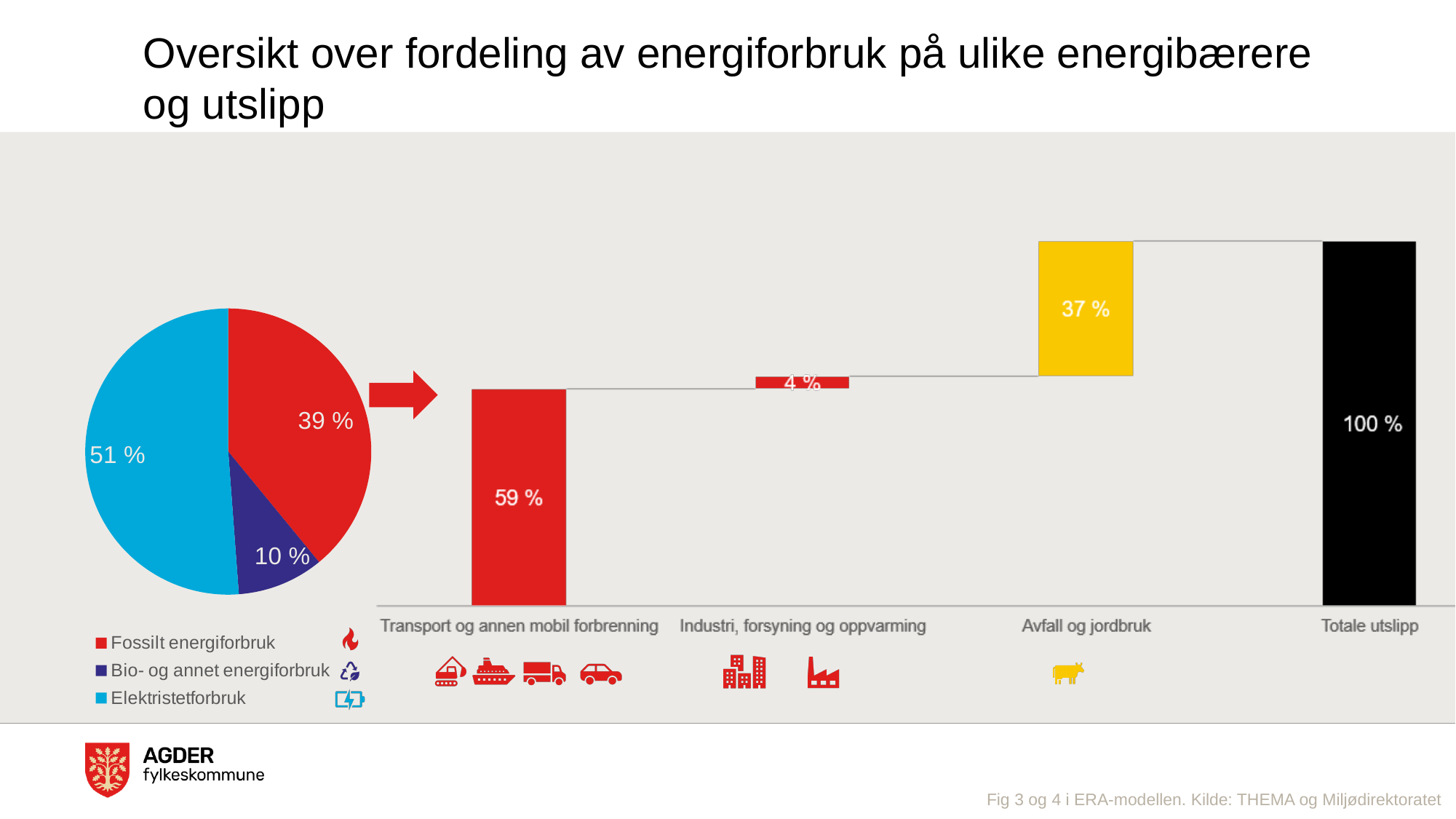
In the bar chart on the right, what value is labelled for Transport og annen mobil forbrenning? 59 % In the pie chart on the left, which category has the smallest slice? Bio- og annet energiforbruk In the pie chart on the left, which category has the largest slice? Elektristetforbruk In the pie chart on the left, what share is labelled for Bio- og annet energiforbruk? 10 % In the bar chart on the right, which of the three emission sources (excluding Totale utslipp) has the lowest value? Industri, forsyning og oppvarming In the pie chart on the left, what is the difference between the shares for Elektristetforbruk and Fossilt energiforbruk? 12 % In the pie chart on the left, what share is labelled for Elektristetforbruk? 51 % In the bar chart on the right, what value is labelled for Avfall og jordbruk? 37 % In the pie chart on the left, what share is labelled for Fossilt energiforbruk? 39 % In the pie chart on the left, how many categories does the legend list? 3 In the bar chart on the right, what value is labelled for Industri, forsyning og oppvarming? 4 % In the bar chart on the right, what is the difference between the values for Transport og annen mobil forbrenning and Avfall og jordbruk? 22 %